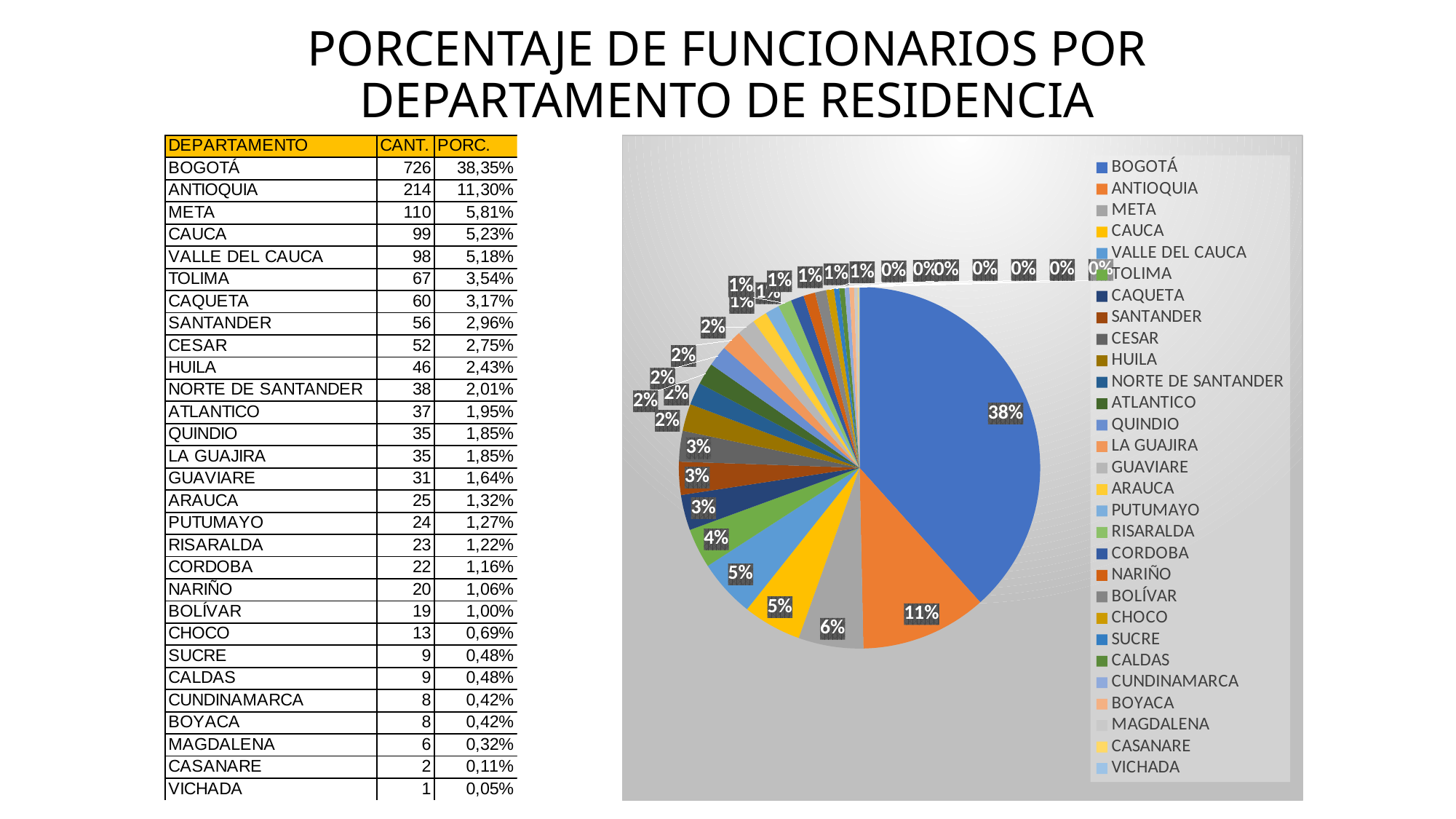
What percentage label is shown on the ANTIOQUIA slice of the pie chart? 11% According to the pie chart labels, what is the difference between the BOGOTÁ share and the ANTIOQUIA share? 27% What is the title of the slide containing the pie chart? PORCENTAJE DE FUNCIONARIOS POR DEPARTAMENTO DE RESIDENCIA What percentage label is shown on the BOGOTÁ slice of the pie chart? 38% What colour is the BOGOTÁ slice in the pie chart? blue How many departments are listed in the pie chart legend? 29 What kind of chart is shown on the slide? pie chart What percentage label is shown on the META slice of the pie chart? 6% Which department has the smallest share in the pie chart? VICHADA Which slice is larger in the pie chart, BOGOTÁ or ANTIOQUIA? BOGOTÁ What percentage label is shown on the TOLIMA slice of the pie chart? 4% Which department has the largest slice in the pie chart? BOGOTÁ